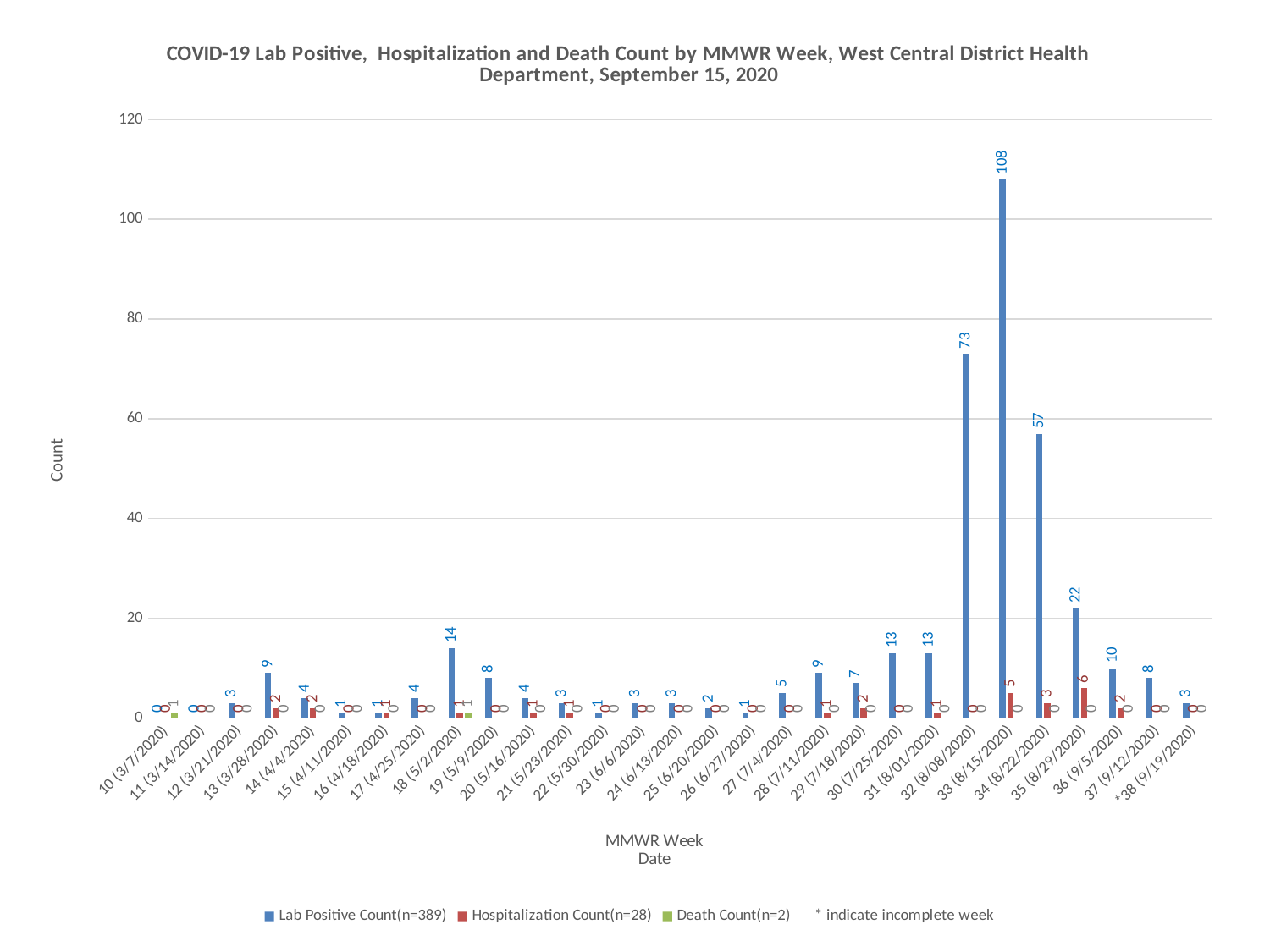
What is the difference between the Lab Positive Count for week 33 (8/15/2020) and week 34 (8/22/2020)? 51 Which has a larger Lab Positive Count, week 34 (8/22/2020) or week 35 (8/29/2020)? 34 (8/22/2020) Is the Lab Positive Count for week 33 (8/15/2020) greater or less than 100? greater Which MMWR week has the highest Hospitalization Count? 35 (8/29/2020) What is the Hospitalization Count for week 33 (8/15/2020)? 5 What kind of chart is shown on the slide? bar chart How many series does the legend list? 3 According to the legend, what is the total n for the Lab Positive Count series? 389 What is the Lab Positive Count for MMWR week 33 (8/15/2020)? 108 Which MMWR week has the highest Lab Positive Count? 33 (8/15/2020) What is the Lab Positive Count for MMWR week 32 (8/08/2020)? 73 How many MMWR weeks are shown on the x axis? 29